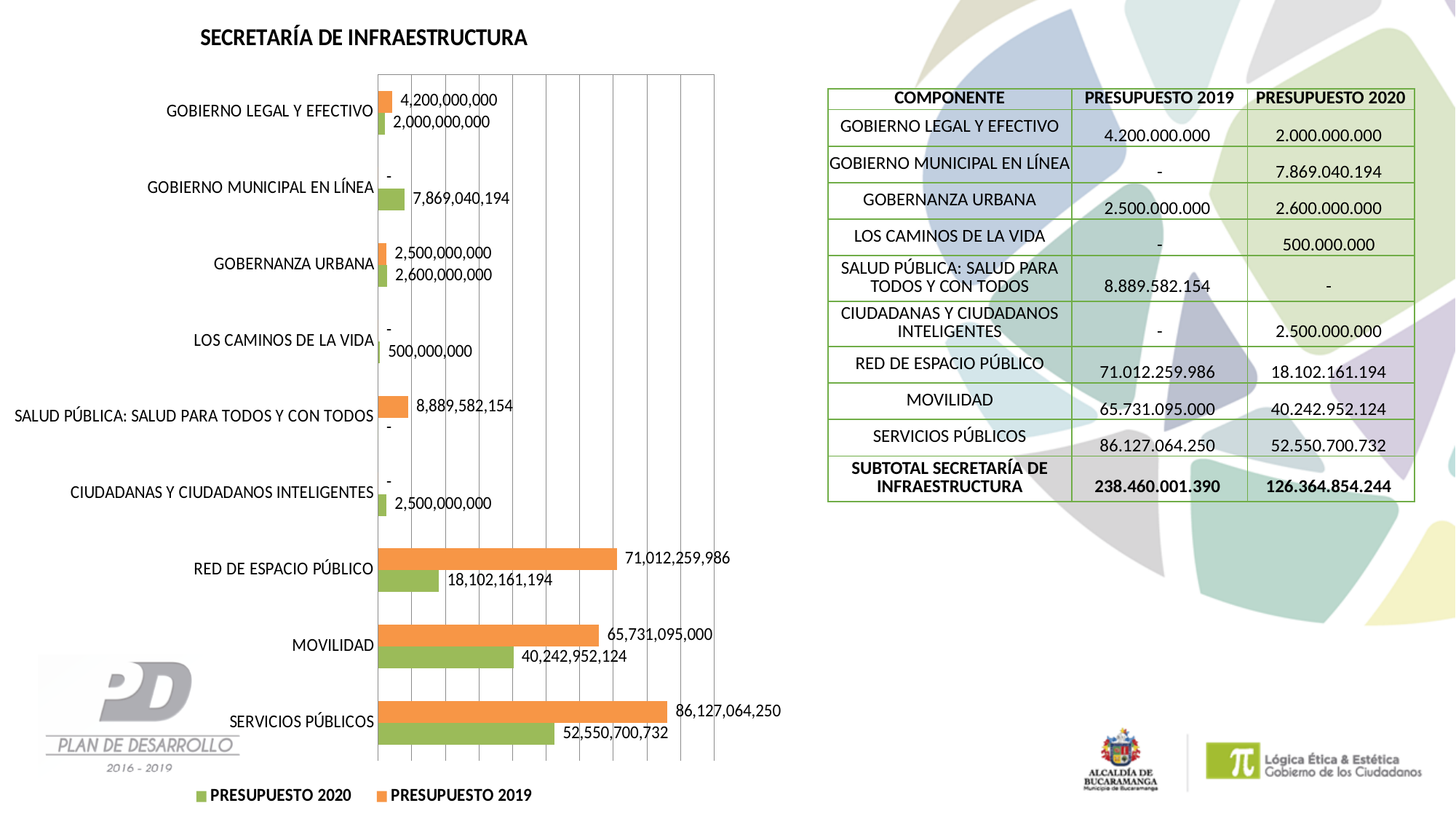
What is the PRESUPUESTO 2020 value for GOBIERNO MUNICIPAL EN LÍNEA in the chart? 7,869,040,194 Which colour represents the PRESUPUESTO 2019 series in the chart? Orange How many series does the chart legend list? 2 What is the difference between the PRESUPUESTO 2019 and PRESUPUESTO 2020 values for RED DE ESPACIO PÚBLICO? 52,910,098,792 Which category has the lowest non-zero PRESUPUESTO 2020 value in the chart? LOS CAMINOS DE LA VIDA What is the PRESUPUESTO 2020 value for MOVILIDAD in the chart? 40,242,952,124 How many categories are shown on the chart? 9 What type of chart is shown on the slide? Bar chart Which category has the highest PRESUPUESTO 2019 value in the chart? SERVICIOS PÚBLICOS What is the PRESUPUESTO 2019 value for SERVICIOS PÚBLICOS in the chart? 86,127,064,250 For GOBERNANZA URBANA, which is larger: the PRESUPUESTO 2019 value or the PRESUPUESTO 2020 value? PRESUPUESTO 2020 What is the difference between the PRESUPUESTO 2019 and PRESUPUESTO 2020 values for SERVICIOS PÚBLICOS? 33,576,363,518